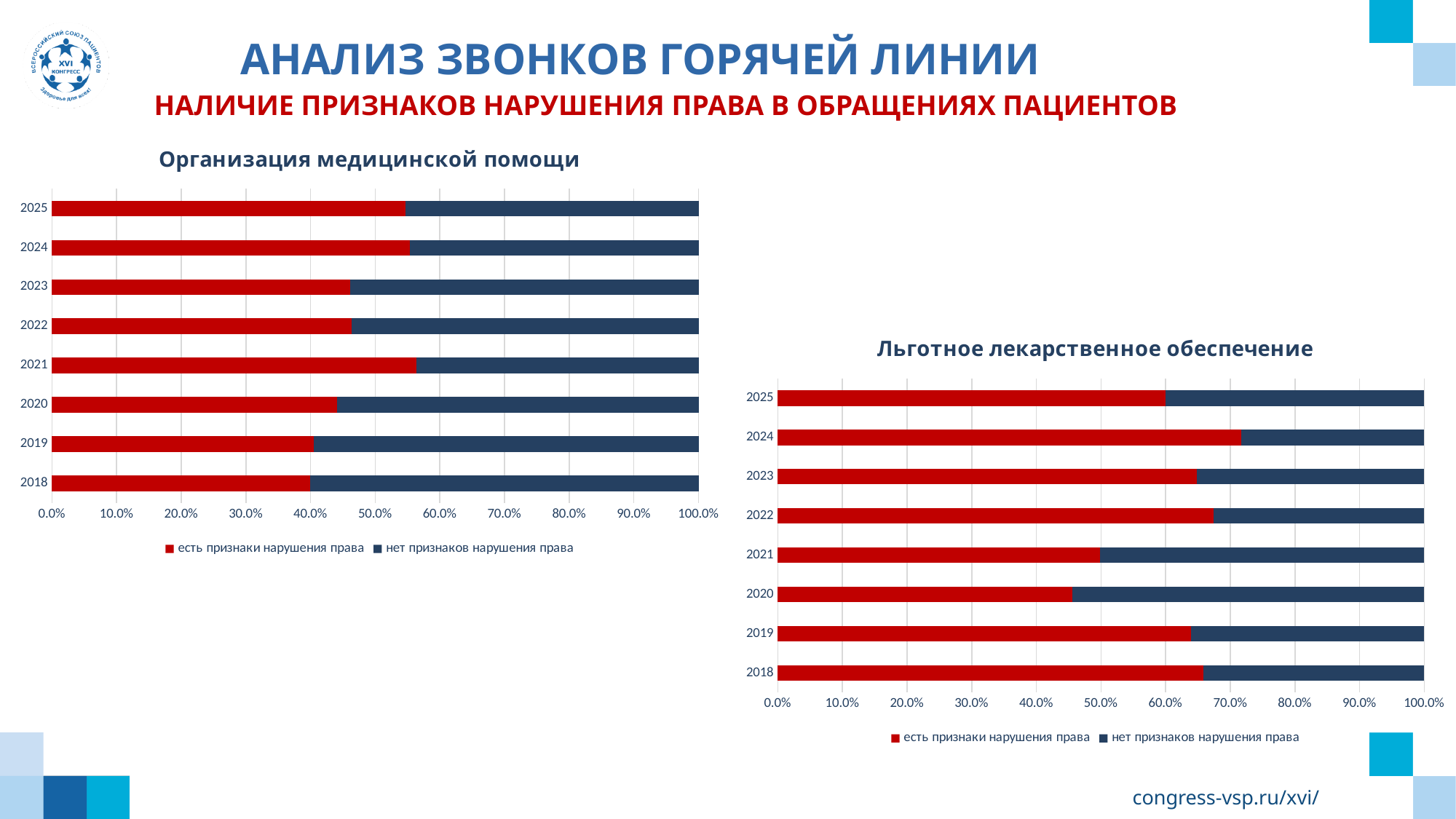
How many series does the legend of the 'Организация медицинской помощи' chart list? 2 How many years are shown on the 'Льготное лекарственное обеспечение' chart? 8 Which colour represents 'нет признаков нарушения права' in the charts? Dark blue In the 'Организация медицинской помощи' chart, is the share of 'есть признаки нарушения права' for 2019 greater or less than 50.0%? less In the 'Льготное лекарственное обеспечение' chart, is the share of 'есть признаки нарушения права' for 2024 greater or less than 60.0%? greater In the 'Организация медицинской помощи' chart, which year has the larger share of 'есть признаки нарушения права': 2021 or 2023? 2021 What kind of chart is the 'Организация медицинской помощи' chart? Stacked bar chart In the 'Льготное лекарственное обеспечение' chart, which year has the largest share of 'есть признаки нарушения права'? 2024 In the 'Льготное лекарственное обеспечение' chart, is the share of 'есть признаки нарушения права' for 2020 greater or less than 50.0%? less In the 'Льготное лекарственное обеспечение' chart, which year has the smallest share of 'есть признаки нарушения права'? 2020 In the 'Льготное лекарственное обеспечение' chart, which year has the larger share of 'есть признаки нарушения права': 2021 or 2022? 2022